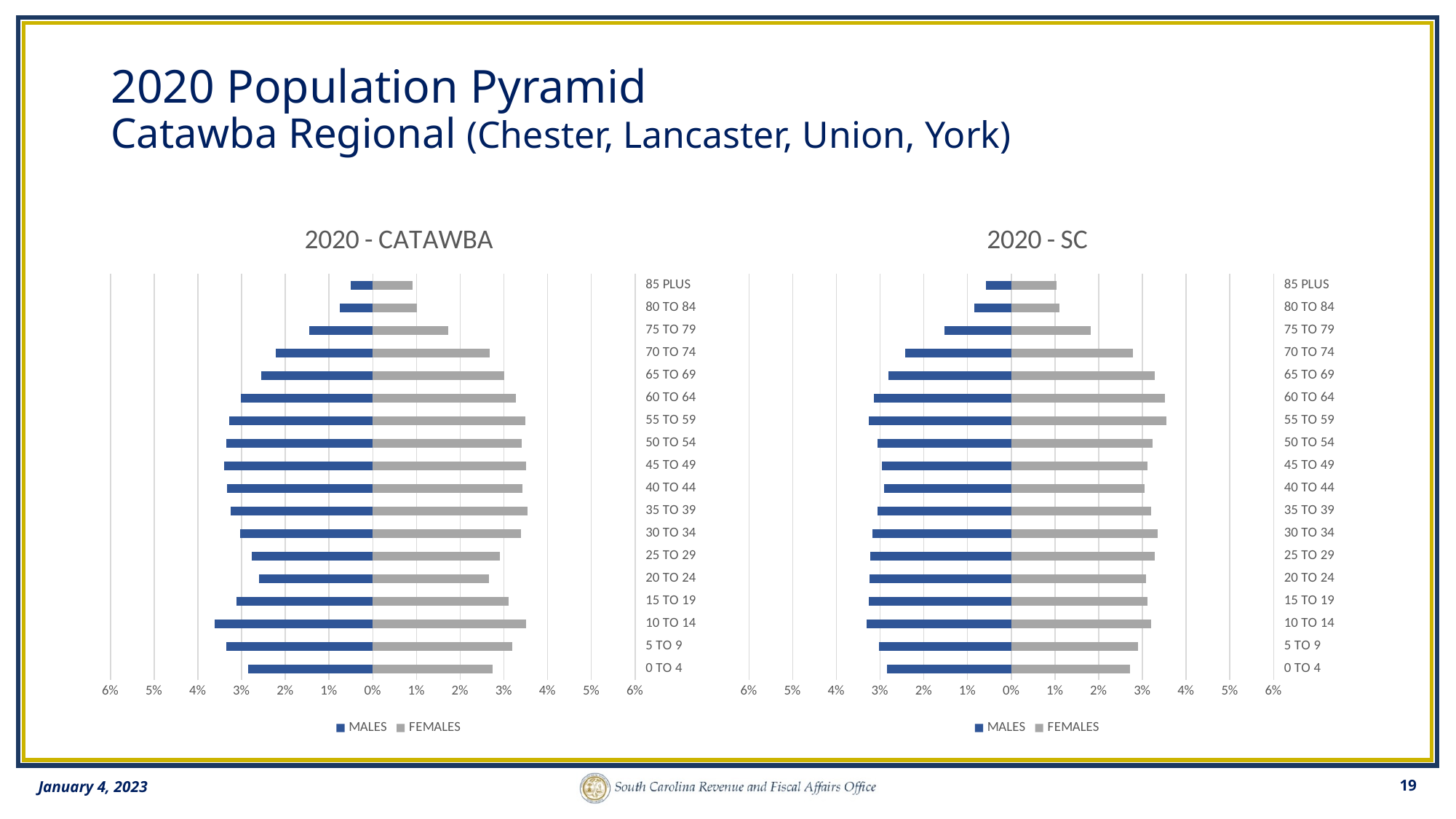
In the 2020 - CATAWBA chart, for the 70 TO 74 age group, which is larger, the MALES value or the FEMALES value? FEMALES What is the title of the chart on the right side of the slide? 2020 - SC In the 2020 - CATAWBA chart, which age group has the smallest MALES value? 85 PLUS In the 2020 - SC chart, which age group has the smallest MALES value? 85 PLUS In the 2020 - CATAWBA chart, is the MALES value for 10 TO 14 greater or less than 3%? greater In the 2020 - CATAWBA chart, which age group has the largest MALES value? 10 TO 14 What are the two series named in the legend of the 2020 - SC chart? MALES and FEMALES What kind of chart is the 2020 - CATAWBA chart? bar chart How many age groups are shown on the 2020 - SC chart? 18 How many series does the legend of the 2020 - CATAWBA chart list? 2 In the 2020 - SC chart, is the FEMALES value for 75 TO 79 greater or less than 1%? greater